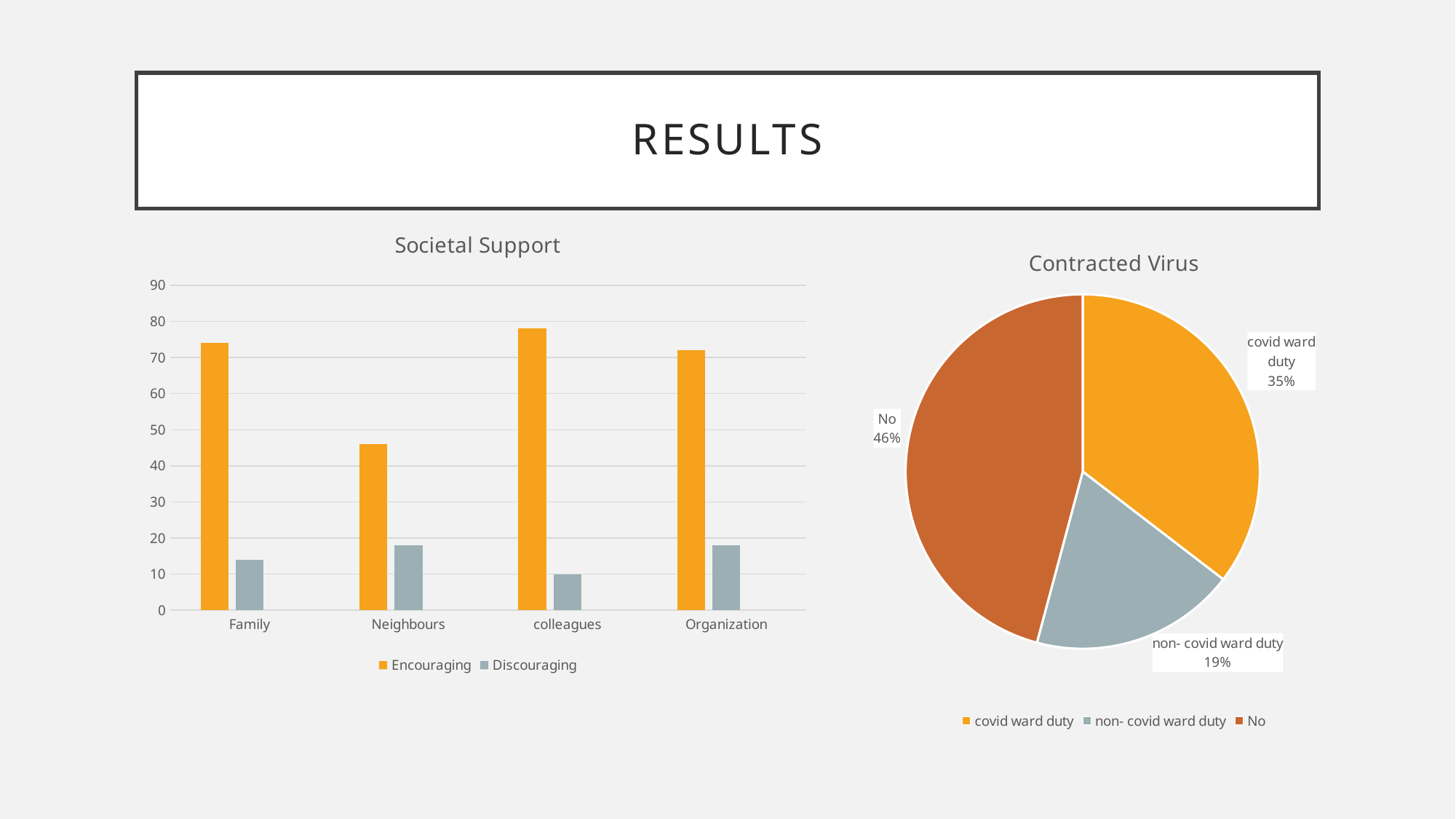
In the Contracted Virus pie chart, what share is labelled for covid ward duty? 35% How many series does the legend of the Societal Support chart list? 2 What kind of chart is the Societal Support chart? bar chart In the Contracted Virus pie chart, how many percentage points larger is the No slice than the covid ward duty slice? 11 How many slices does the Contracted Virus pie chart have? 3 In the Societal Support chart, which is larger for colleagues: the Encouraging value or the Discouraging value? Encouraging In the Contracted Virus pie chart, which slice is the largest? No In the Contracted Virus pie chart, which slice is the smallest? non- covid ward duty In the Societal Support chart, which category has the lowest Encouraging value? Neighbours In the Contracted Virus pie chart, what share is labelled for non- covid ward duty? 19% In the Societal Support chart, is the Encouraging value for Family greater or less than 70? greater In the Societal Support chart, is the Encouraging value for Neighbours greater or less than 50? less